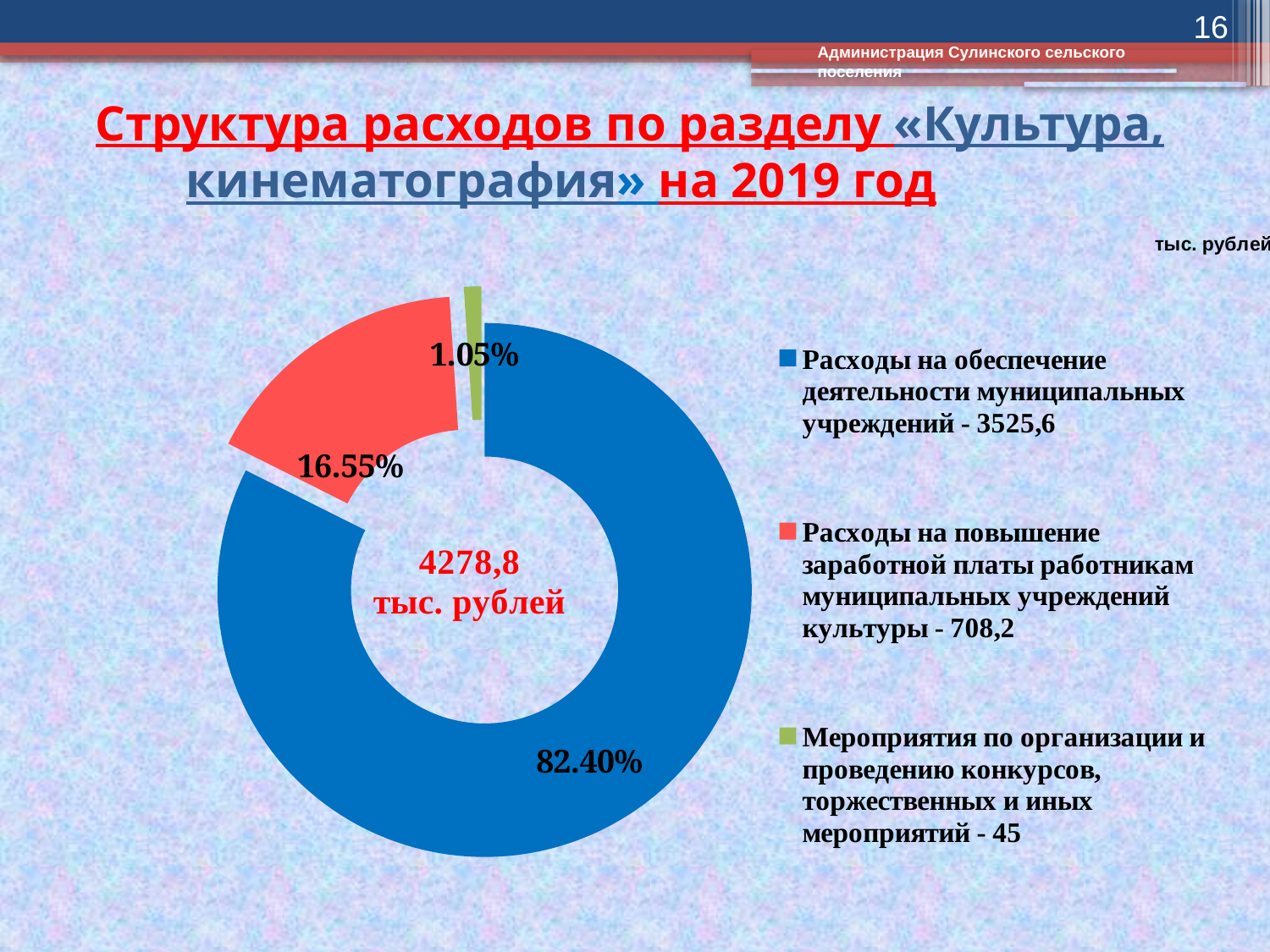
What share of the chart is labelled for 'Расходы на повышение заработной платы работникам муниципальных учреждений культуры'? 16.55% What value (тыс. рублей) does the legend give for 'Расходы на повышение заработной платы работникам муниципальных учреждений культуры'? 708,2 What value (тыс. рублей) does the legend give for 'Расходы на обеспечение деятельности муниципальных учреждений'? 3525,6 Which category has the smallest share of the chart? Мероприятия по организации и проведению конкурсов, торжественных и иных мероприятий What share of the chart is labelled for 'Расходы на обеспечение деятельности муниципальных учреждений'? 82.40% How many slices does the chart have? 3 What total amount is printed in the centre of the chart? 4278,8 тыс. рублей What kind of chart is shown on the slide? Doughnut (pie) chart What value (тыс. рублей) does the legend give for 'Мероприятия по организации и проведению конкурсов, торжественных и иных мероприятий'? 45 What share of the chart is labelled for 'Мероприятия по организации и проведению конкурсов, торжественных и иных мероприятий'? 1.05% How many entries does the legend list? 3 Which category has the largest share of the chart? Расходы на обеспечение деятельности муниципальных учреждений